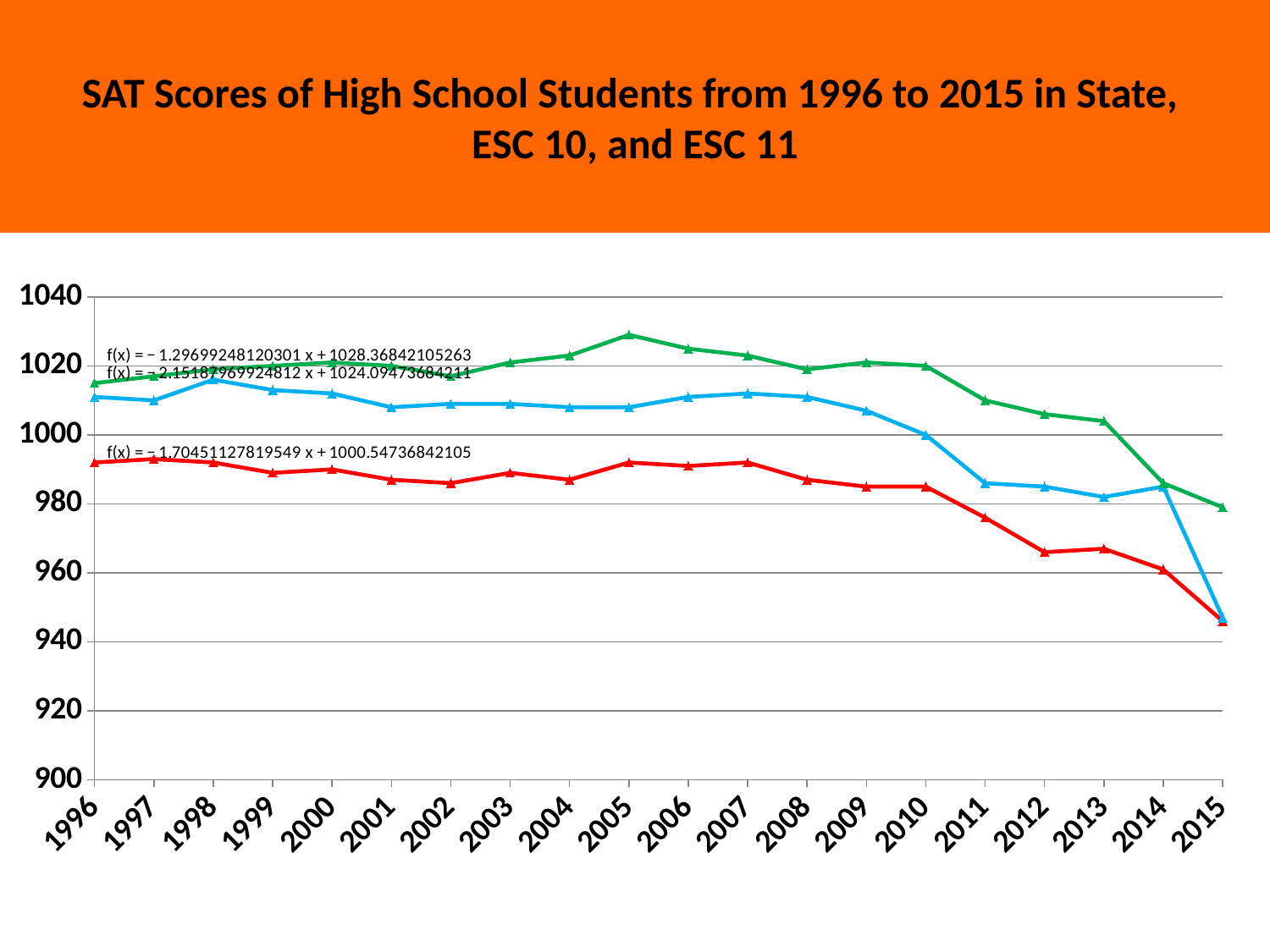
Is the value of the red line in 2015 greater or less than 960? less Is the value of the green line in 2005 greater or less than 1020? greater Do the plotted SAT scores generally rise or fall from 1996 to 2015? fall How many lines are plotted on the chart? 3 Is the value of the green line in 2015 greater or less than 1000? less What is the title of the chart? SAT Scores of High School Students from 1996 to 2015 in State, ESC 10, and ESC 11 In which year does the green line reach its highest value? 2005 In 2014, which line is higher, the blue line or the red line? blue line What kind of chart is shown on the slide? line chart In which year does the red line reach its lowest value? 2015 How many years are plotted along the x axis? 20